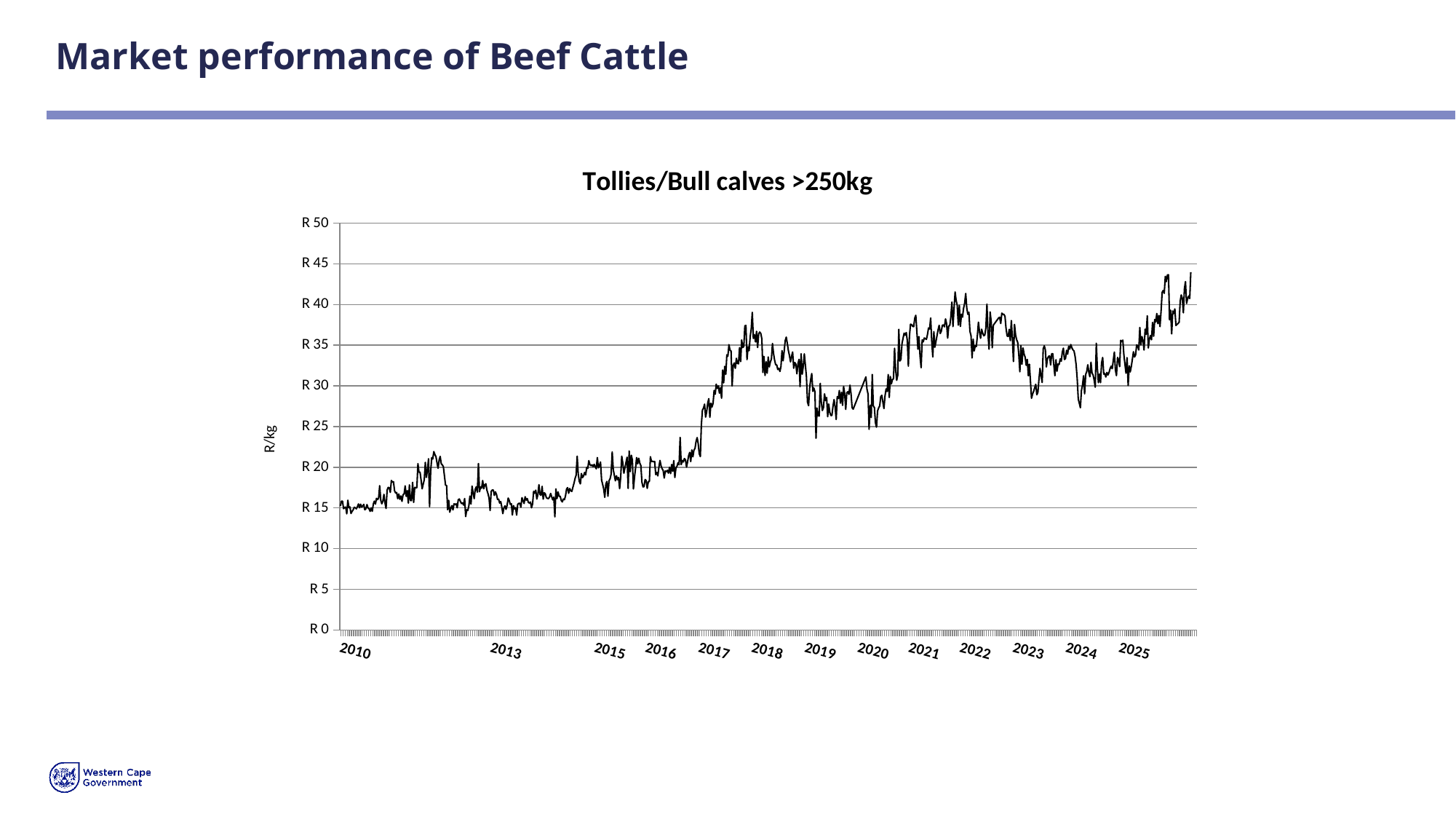
How many lines are plotted on the chart? 1 Is the value at the end of the series in 2025 greater or less than R 40? greater What is the highest tick value shown on the vertical axis? R 50 Is the value around 2021 greater or less than R 30? greater What is the label on the vertical axis of the chart? R/kg What kind of chart is shown on the slide? line chart Is the value around 2013 greater or less than R 25? less What is the title of the chart? Tollies/Bull calves >250kg Overall, do the values rise or fall from 2010 to 2025? rise